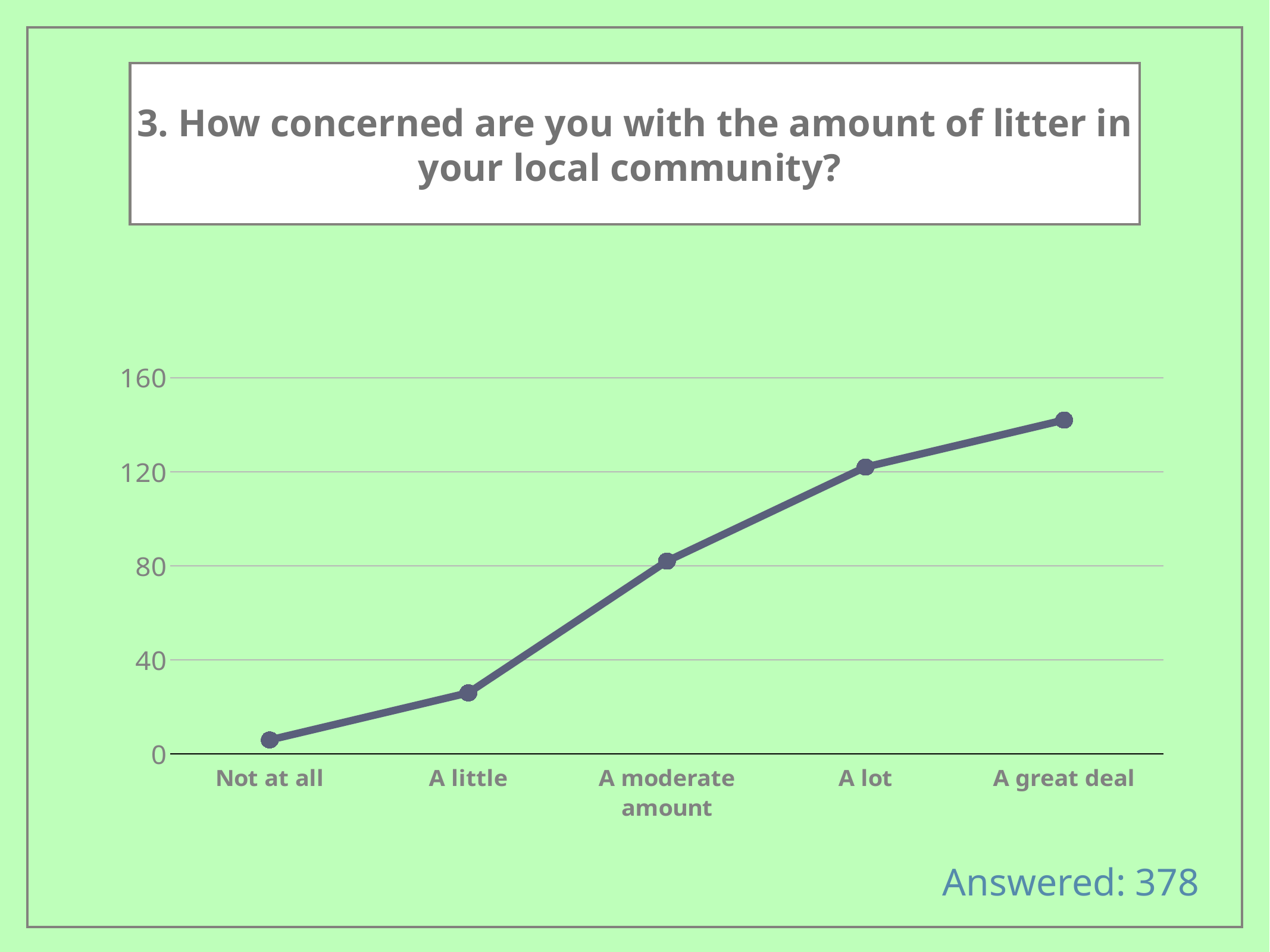
How many categories are plotted along the x axis? 5 Is the value for 'A lot' greater or less than 80? greater Which category has the highest value? A great deal Is the value for 'A great deal' greater or less than 160? less How many responses were answered according to the note on the slide? 378 Is the value for 'A little' greater or less than 40? less Which category has the lowest value? Not at all Do the values rise or fall moving from 'Not at all' to 'A great deal' along the x axis? rise Which is larger, the value for 'A lot' or the value for 'A little'? A lot What kind of chart is shown on the slide? line chart